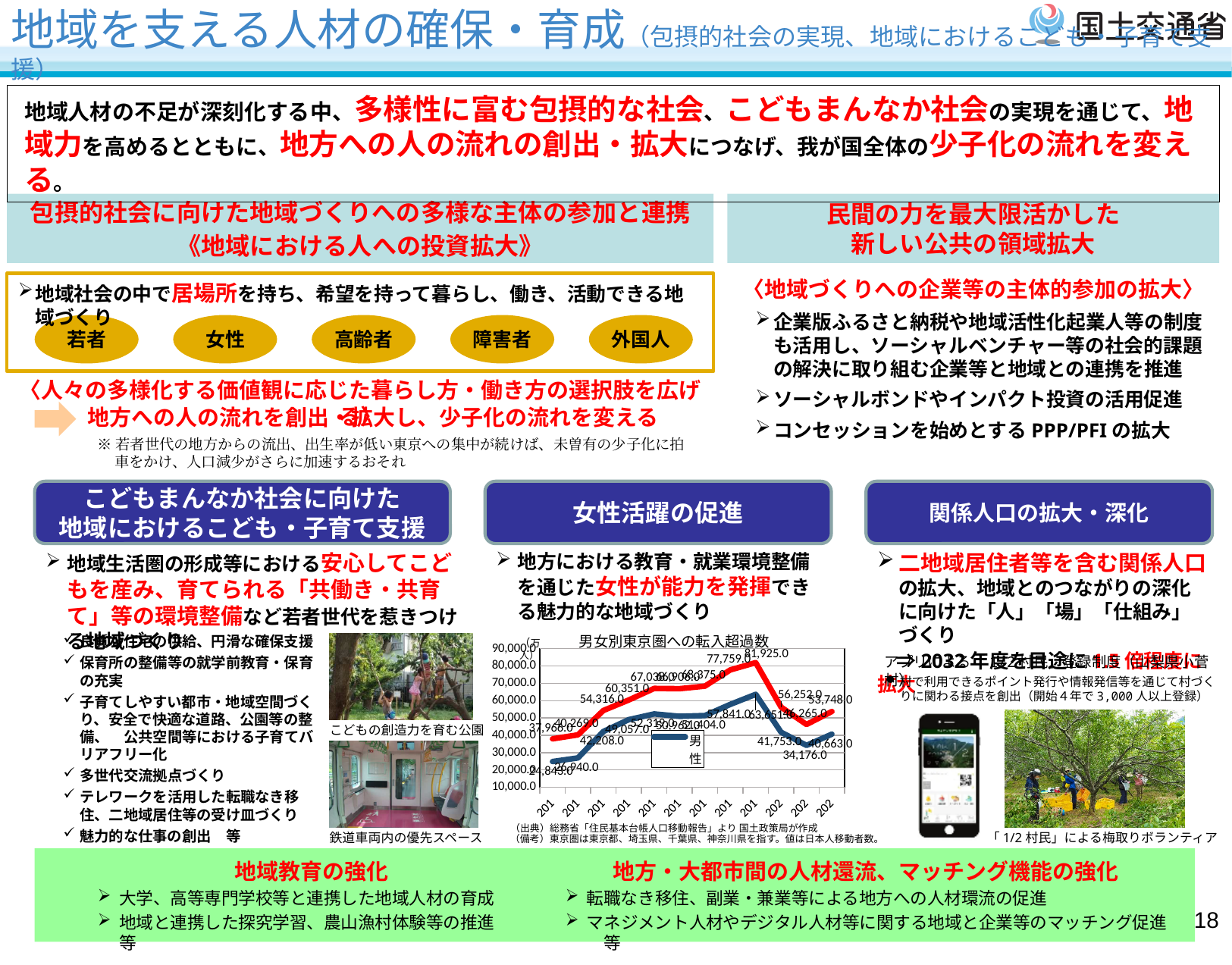
In the chart 男女別東京圏への転入超過数, what is the lowest value shown on the vertical axis? 10,000.0 In the chart 男女別東京圏への転入超過数, do the values generally rise or fall from the first point up to the peak? rise In the chart 男女別東京圏への転入超過数, what is the highest value labelled on the blue line? 63,651.0 What is the title of the line chart on the slide? 男女別東京圏への転入超過数 In the chart 男女別東京圏への転入超過数, what is the difference between the peak of the red line (81,925.0) and the peak of the blue line (63,651.0)? 18,274.0 In the chart 男女別東京圏への転入超過数, what is the highest value labelled on the red line? 81,925.0 In the chart 男女別東京圏への転入超過数, is the peak value of the red line greater or less than 80,000.0? greater In the chart 男女別東京圏への転入超過数, which line reaches a higher peak, the red line or the blue line? the red line What kind of chart is shown under the 女性活躍の促進 section? line chart In the chart 男女別東京圏への転入超過数, is the first value of the blue line greater or less than 30,000.0? less In the chart 男女別東京圏への転入超過数, is the peak value of the blue line greater or less than 70,000.0? less